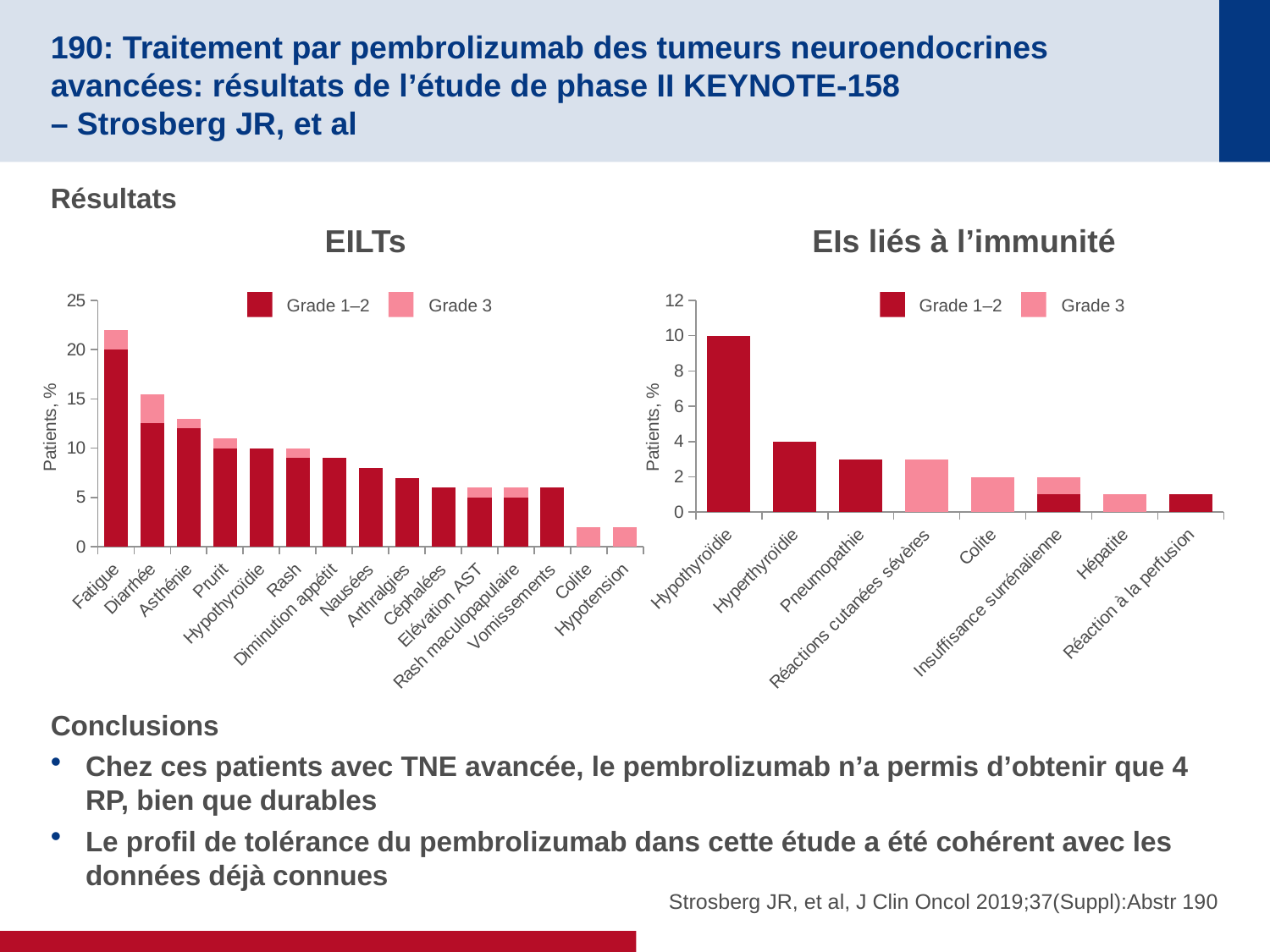
On the EIs liés à l'immunité chart, what is the value for Hyperthyroïdie? 4 On the EILTs chart, how many adverse event categories are shown on the x axis? 15 On the EILTs chart, which is larger, the total for Asthénie or the total for Arthralgies? Asthénie On the EILTs chart, what kind of chart is shown? bar chart On the EILTs chart, how many series does the legend list? 2 On the EIs liés à l'immunité chart, is the value for Pneumopathie greater or less than 4? less On the EIs liés à l'immunité chart, which category has the highest percentage of patients? Hypothyroïdie On the EILTs chart, is the value for Nausées greater or less than 10? less On the EIs liés à l'immunité chart, how many categories are shown on the x axis? 8 On the EILTs chart, which category has the highest total percentage of patients? Fatigue On the EILTs chart, what is the Grade 1–2 value for Hypothyroïdie? 10